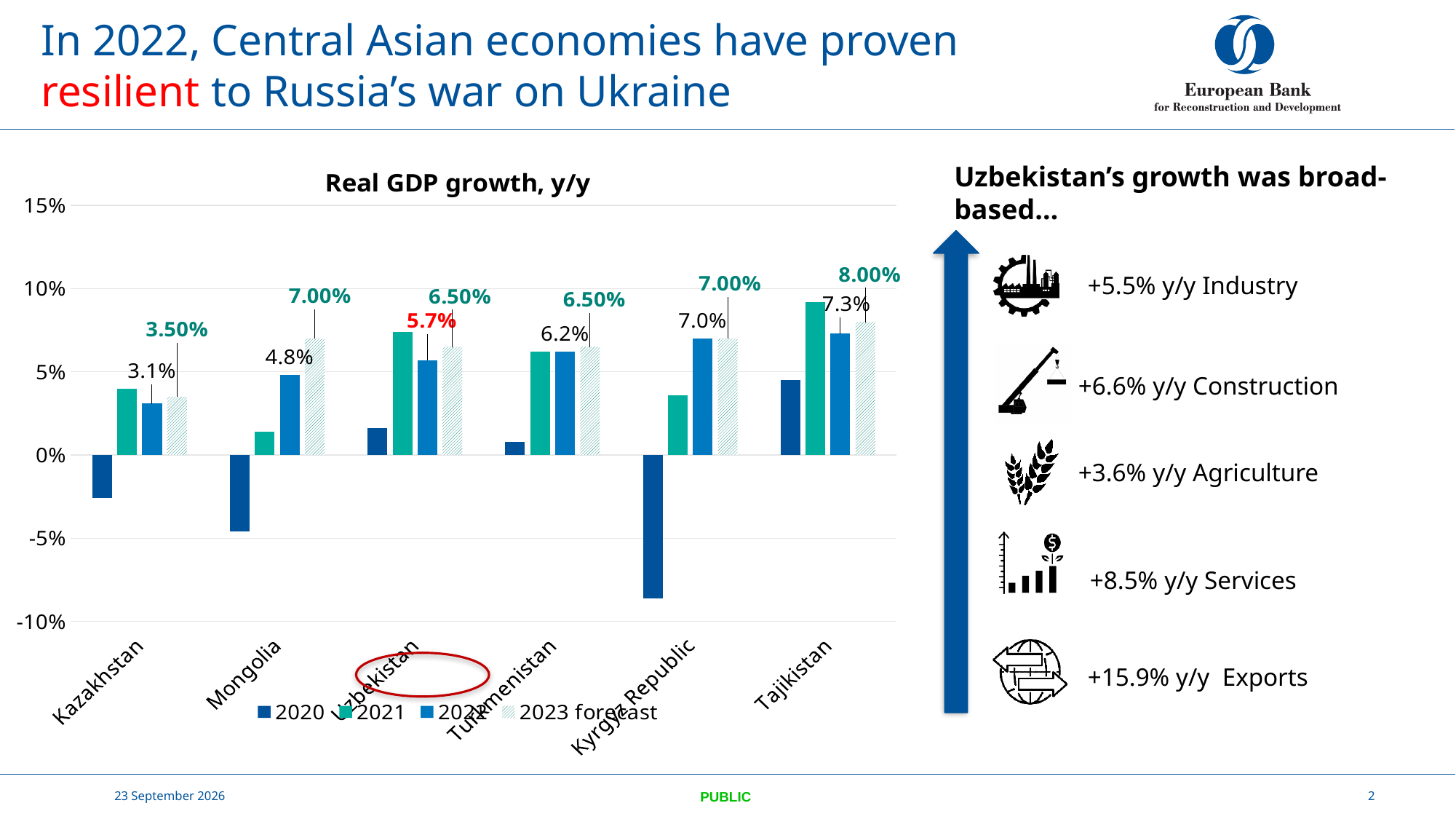
In the Real GDP growth chart, is the 2020 value for the Kyrgyz Republic greater or less than -5%? less How many series does the legend of the Real GDP growth chart list? 4 In the Real GDP growth chart, what is the 2023 forecast value for Tajikistan? 8.00% In the Real GDP growth chart, which is larger: the 2023 forecast for Mongolia or for Uzbekistan? Mongolia How many countries are shown on the x axis of the Real GDP growth chart? 6 In the Real GDP growth chart, what is the 2022 value for Kazakhstan? 3.1% In the Real GDP growth chart, which country has the highest 2022 value? Tajikistan In the Real GDP growth chart, which country has the lowest 2023 forecast value? Kazakhstan In the Real GDP growth chart, what is the difference between the 2022 values for Tajikistan and Kazakhstan? 4.2 percentage points In the Real GDP growth chart, what is the 2022 value for Uzbekistan? 5.7% In the Real GDP growth chart, what is the difference between Mongolia's 2023 forecast and its 2022 value? 2.2 percentage points What type of chart is used to show Real GDP growth, y/y? Bar chart